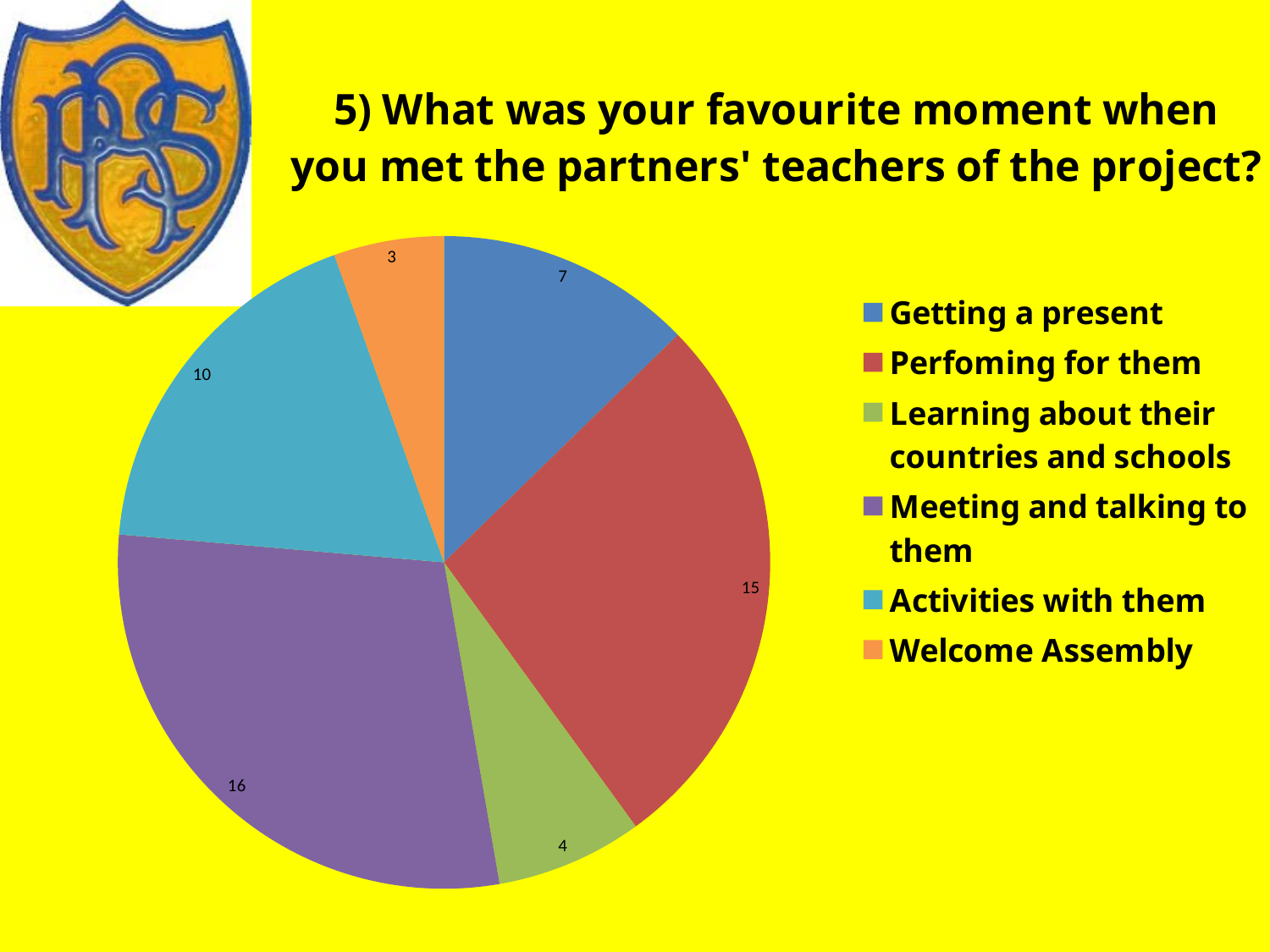
What is the difference between the values for "Meeting and talking to them" and "Activities with them"? 6 What type of chart is shown on the slide? Pie chart What is the value for "Learning about their countries and schools"? 4 Which category has the lowest value in the pie chart? Welcome Assembly Which category has the highest value in the pie chart? Meeting and talking to them What is the value for "Getting a present"? 7 How many categories does the pie chart show? 6 Which is larger, the value for "Getting a present" or the value for "Learning about their countries and schools"? Getting a present What is the value for "Activities with them"? 10 What is the total of all the values shown in the pie chart? 55 What is the value for "Perfoming for them"? 15 What is the value for "Welcome Assembly"? 3